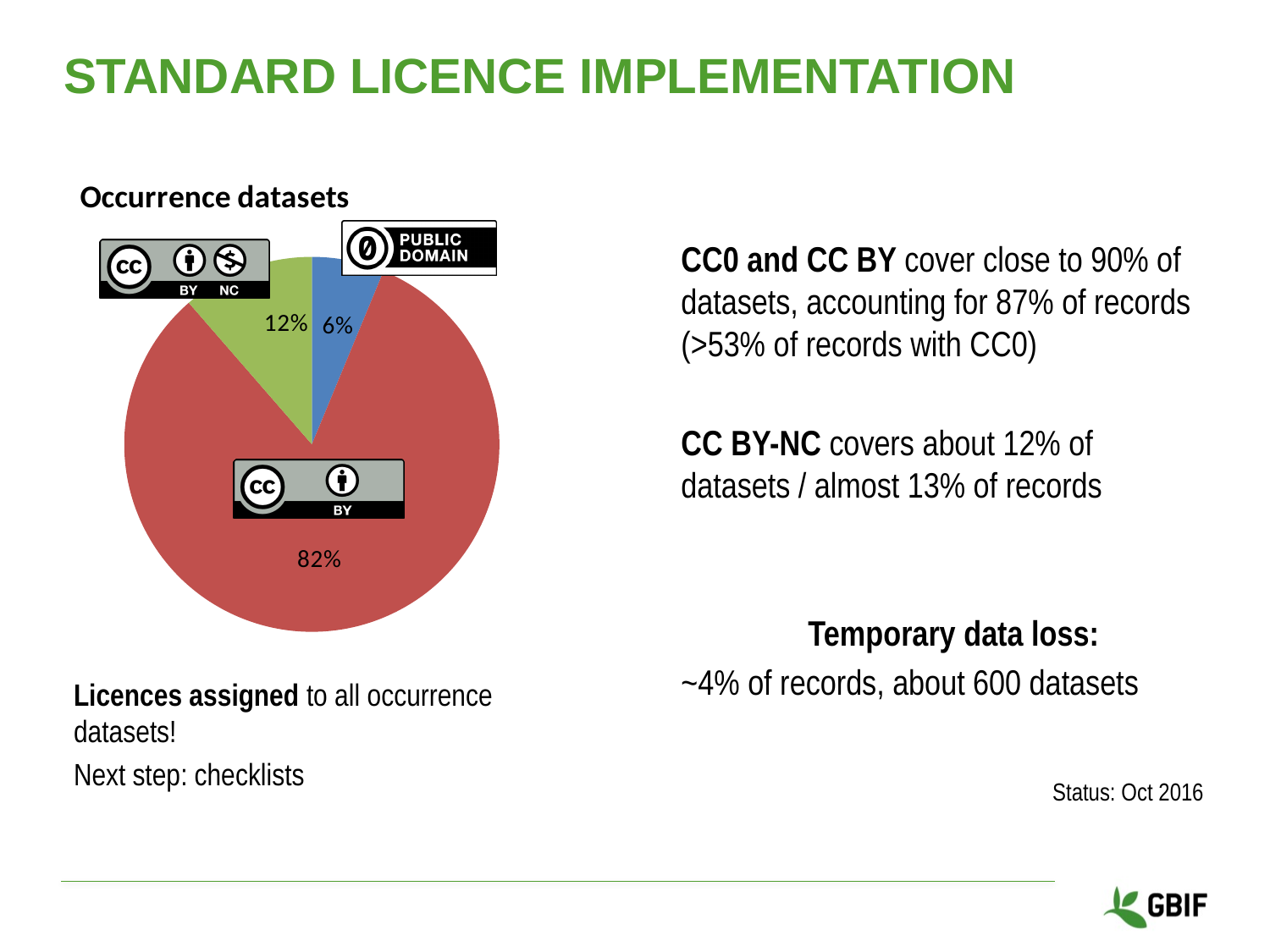
What colour is the CC BY slice in the occurrence datasets pie chart? red What share of occurrence datasets is labelled for the CC BY licence in the pie chart? 82% Which licence has the largest slice in the occurrence datasets pie chart? CC BY Which licence has the smallest slice in the occurrence datasets pie chart? CC0 / Public Domain In the occurrence datasets pie chart, what is the difference in percentage points between the CC BY-NC slice and the CC0 slice? 6 How many slices does the occurrence datasets pie chart have? 3 In the occurrence datasets pie chart, what is the difference in percentage points between the CC BY slice and the CC BY-NC slice? 70 What share of occurrence datasets is labelled for the CC0 / Public Domain licence in the pie chart? 6% What colour is the CC BY-NC slice in the occurrence datasets pie chart? green In the occurrence datasets pie chart, which slice is larger: CC BY-NC or CC0 / Public Domain? CC BY-NC What kind of chart is shown under the heading "Occurrence datasets"? pie chart What share of occurrence datasets is labelled for the CC BY-NC licence in the pie chart? 12%